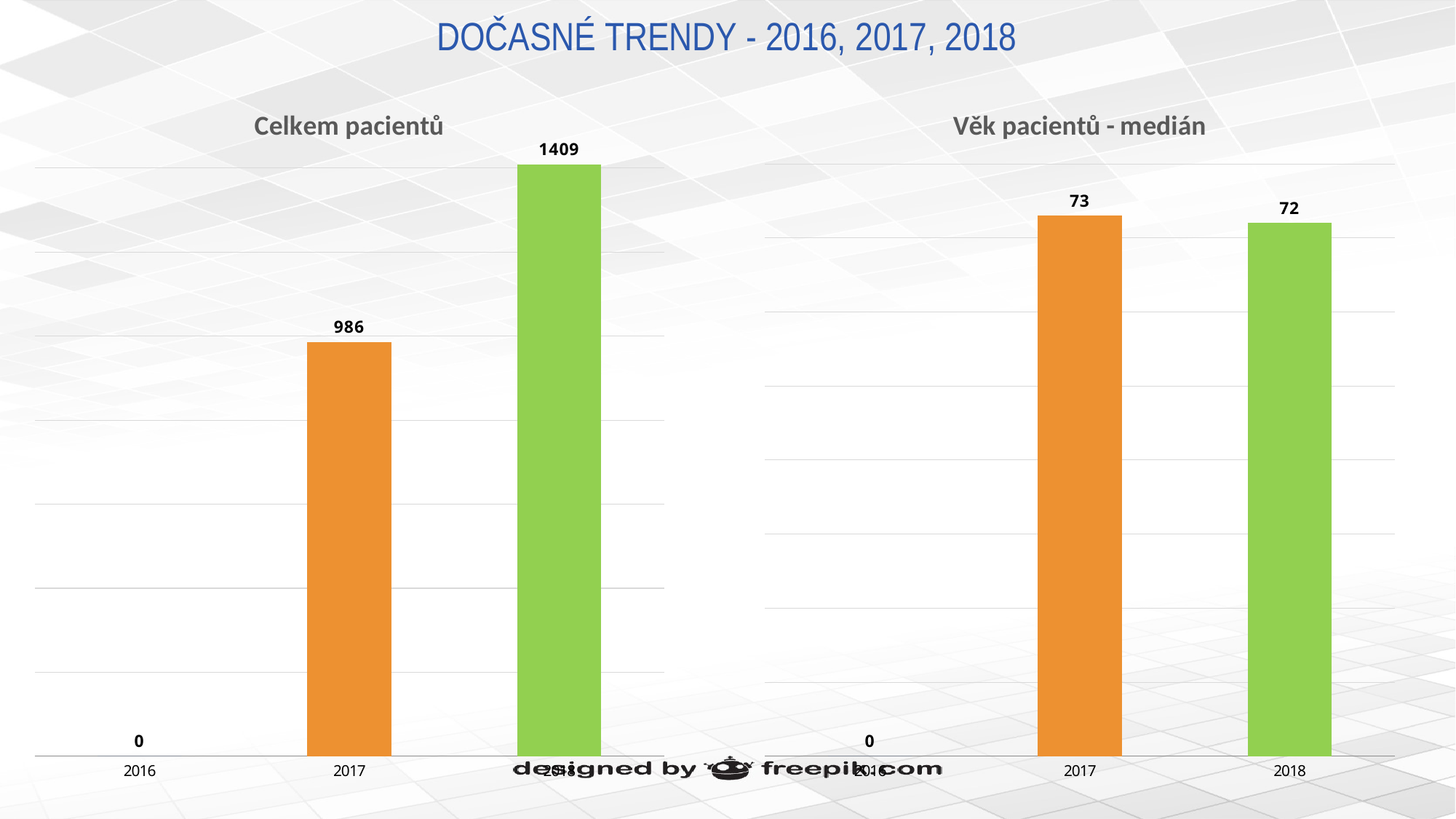
In the 'Celkem pacientů' chart, what is the difference between the values for 2018 and 2017? 423 What kind of chart is the 'Věk pacientů - medián' chart? bar chart In the 'Věk pacientů - medián' chart, what is the value for 2018? 72 In the 'Celkem pacientů' chart, which year has the lowest value? 2016 In the 'Věk pacientů - medián' chart, what is the difference between the values for 2017 and 2018? 1 How many categories does the 'Celkem pacientů' chart show? 3 In the 'Celkem pacientů' chart, what is the value for 2017? 986 In the 'Celkem pacientů' chart, which year has the highest value? 2018 In the 'Celkem pacientů' chart, what is the value for 2018? 1409 In the 'Věk pacientů - medián' chart, which is larger, the value for 2017 or 2018? 2017 In the 'Věk pacientů - medián' chart, what is the value for 2017? 73 In the 'Celkem pacientů' chart, what is the value for 2016? 0